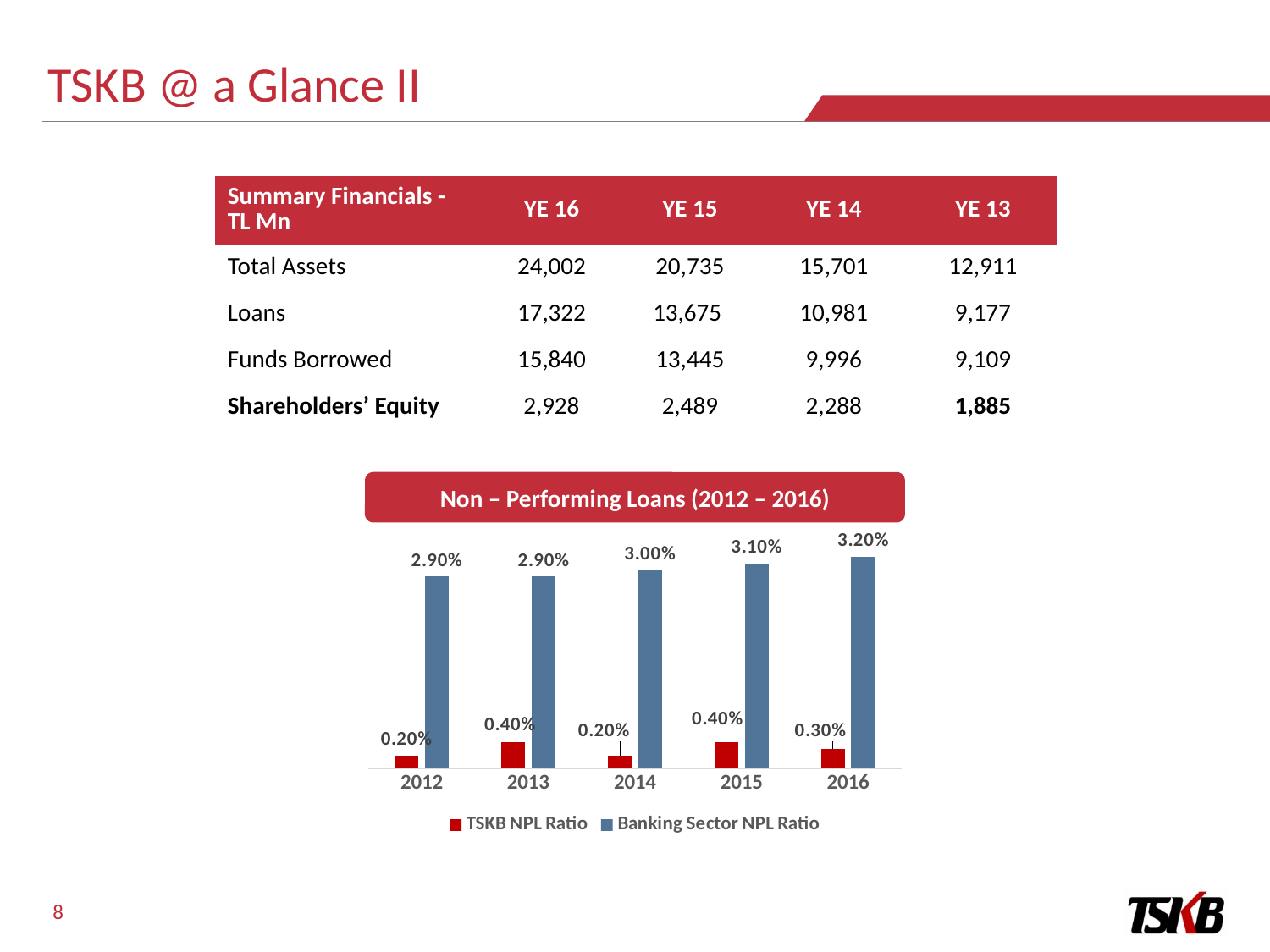
What is the difference between the Banking Sector NPL Ratio and the TSKB NPL Ratio in 2015? 2.70% What is the Banking Sector NPL Ratio for 2016? 3.20% What kind of chart is shown on the slide? Bar chart Does the Banking Sector NPL Ratio rise or fall from 2013 to 2016? Rise Which is larger in 2012, the TSKB NPL Ratio or the Banking Sector NPL Ratio? Banking Sector NPL Ratio What is the TSKB NPL Ratio for 2016? 0.30% What is the TSKB NPL Ratio for 2013? 0.40% What is the Banking Sector NPL Ratio for 2014? 3.00% What is the title of the chart? Non – Performing Loans (2012 – 2016) How many years are shown on the x axis of the chart? 5 How many series does the chart legend list? 2 In which year is the Banking Sector NPL Ratio highest? 2016